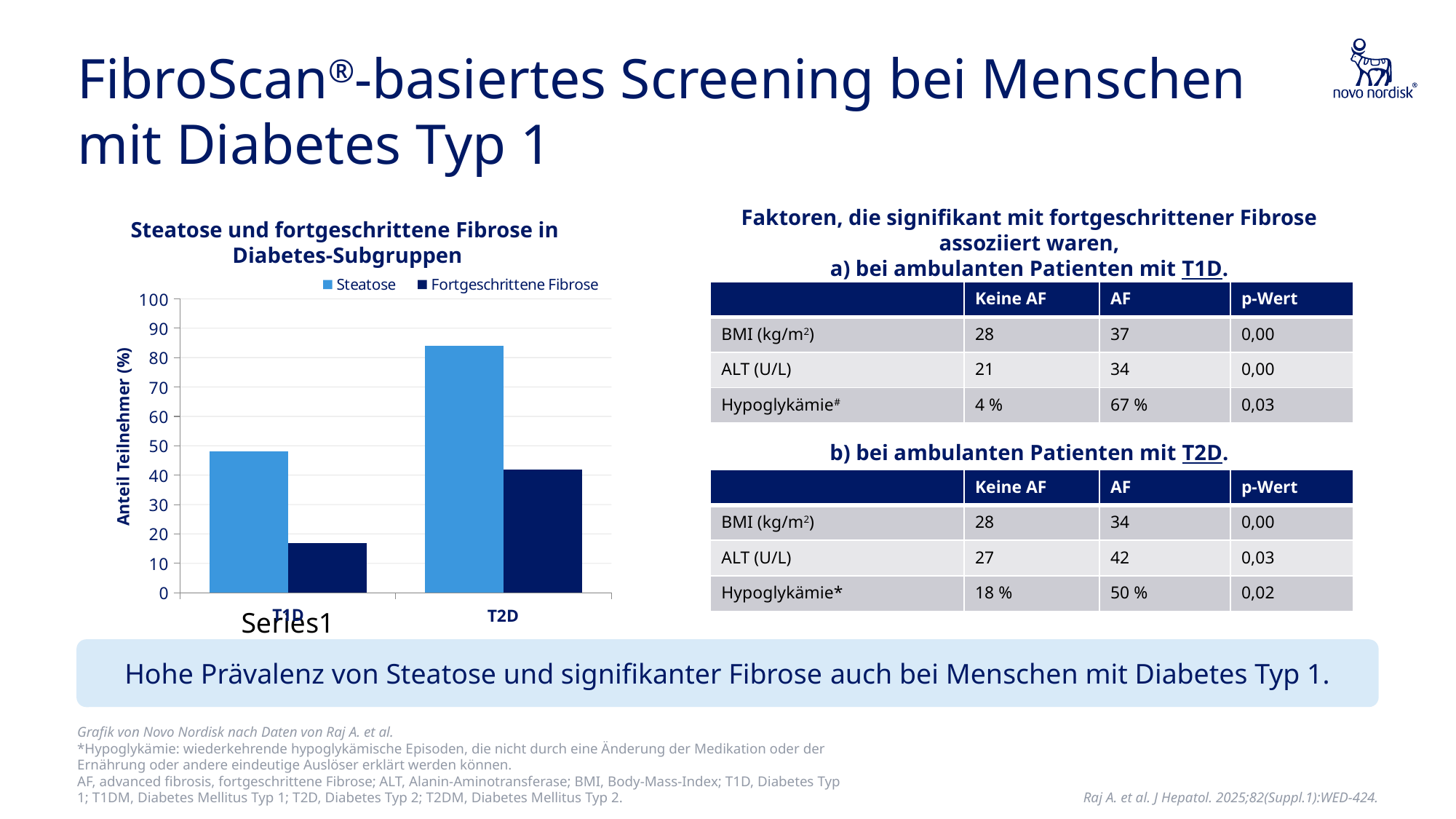
What is the label of the y axis of the chart? Anteil Teilnehmer (%) What kind of chart is shown on the slide? bar chart Which category has the highest Steatose value? T2D How many series does the chart legend list? 2 Is the Fortgeschrittene Fibrose value for T2D greater or less than 40? greater Which category has the lowest Fortgeschrittene Fibrose value? T1D Is the Steatose value for T2D greater or less than 80? greater Which is larger: the Steatose value for T1D or the Fortgeschrittene Fibrose value for T2D? Steatose for T1D Is the Steatose value for T1D greater or less than 50? less Which series in the chart is shown in light blue? Steatose How many categories are shown on the x axis of the chart? 2